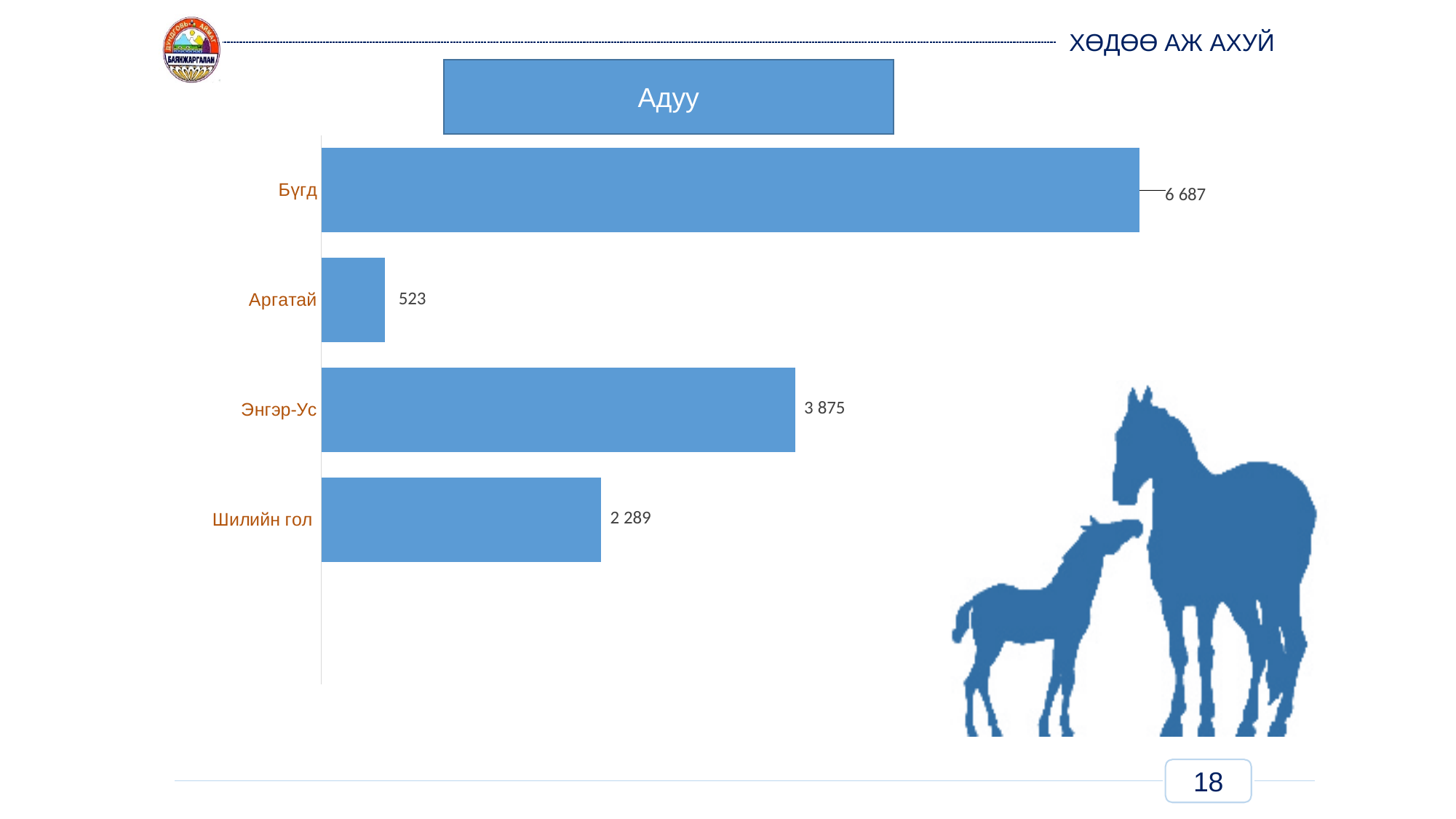
What is the value for Энгэр-Ус? 3 875 What is the value for Бүгд? 6 687 What is the difference between the values for Энгэр-Ус and Шилийн гол? 1 586 What is the title of the chart? Адуу What is the difference between the values for Бүгд and Аргатай? 6 164 Which category has the highest value? Бүгд How many categories are shown in the chart? 4 What is the value for Шилийн гол? 2 289 What is the value for Аргатай? 523 Which is larger, the value for Энгэр-Ус or the value for Шилийн гол? Энгэр-Ус What kind of chart is shown on the slide? Bar chart Which category has the lowest value? Аргатай